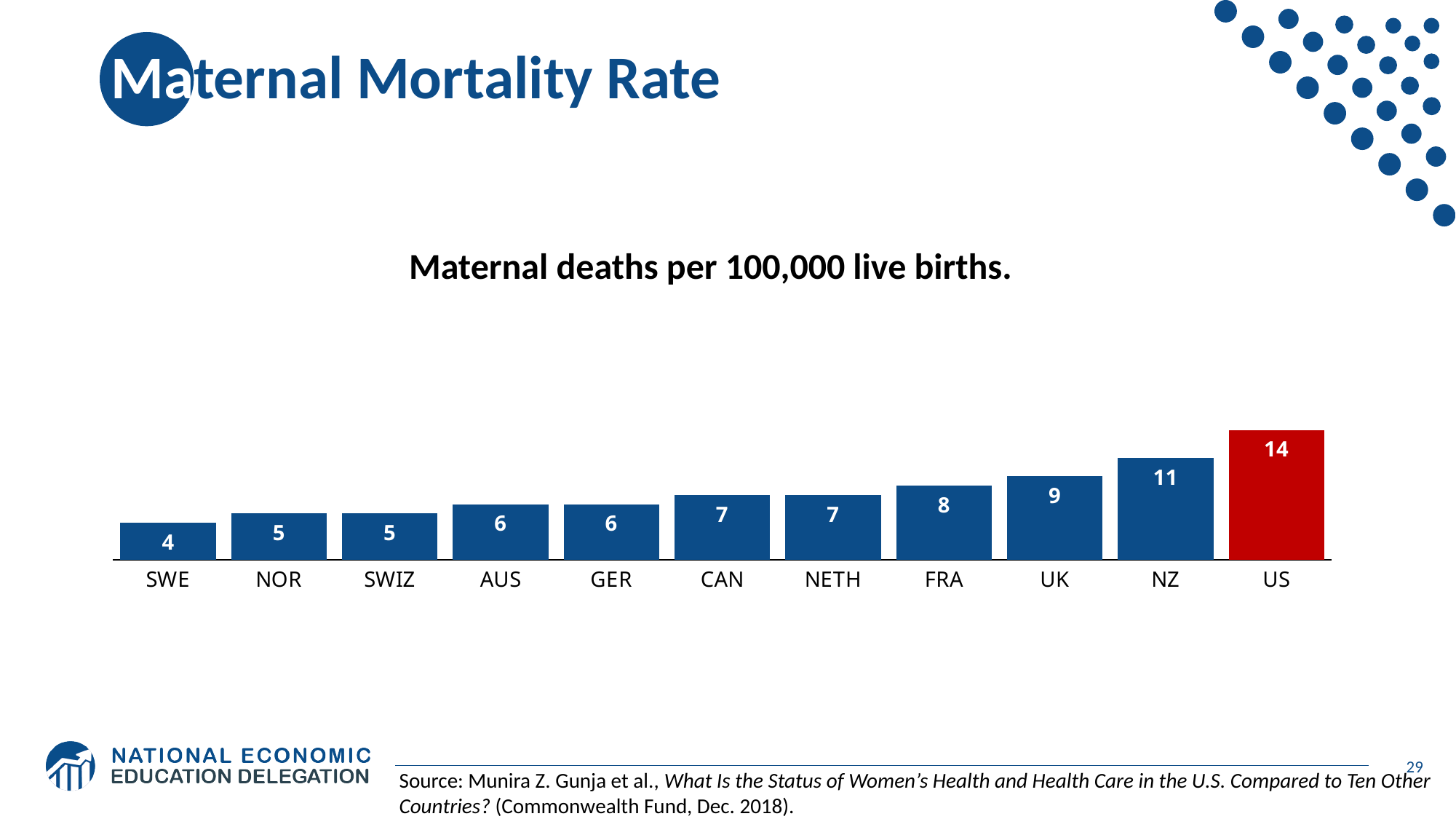
Which country has the lowest maternal mortality rate on the chart? SWE What is the maternal mortality rate shown for the US? 14 How many countries are shown on the chart? 11 What is the difference between the values for the US and the UK? 5 Which has a higher value, CAN or NOR? CAN Which bar is coloured red rather than blue? US What value is shown for FRA? 8 What is the difference between the values for NZ and SWE? 7 Which country has the highest maternal mortality rate on the chart? US What is the value for NZ? 11 What value is shown for SWE? 4 What type of chart is shown on the slide? Bar chart